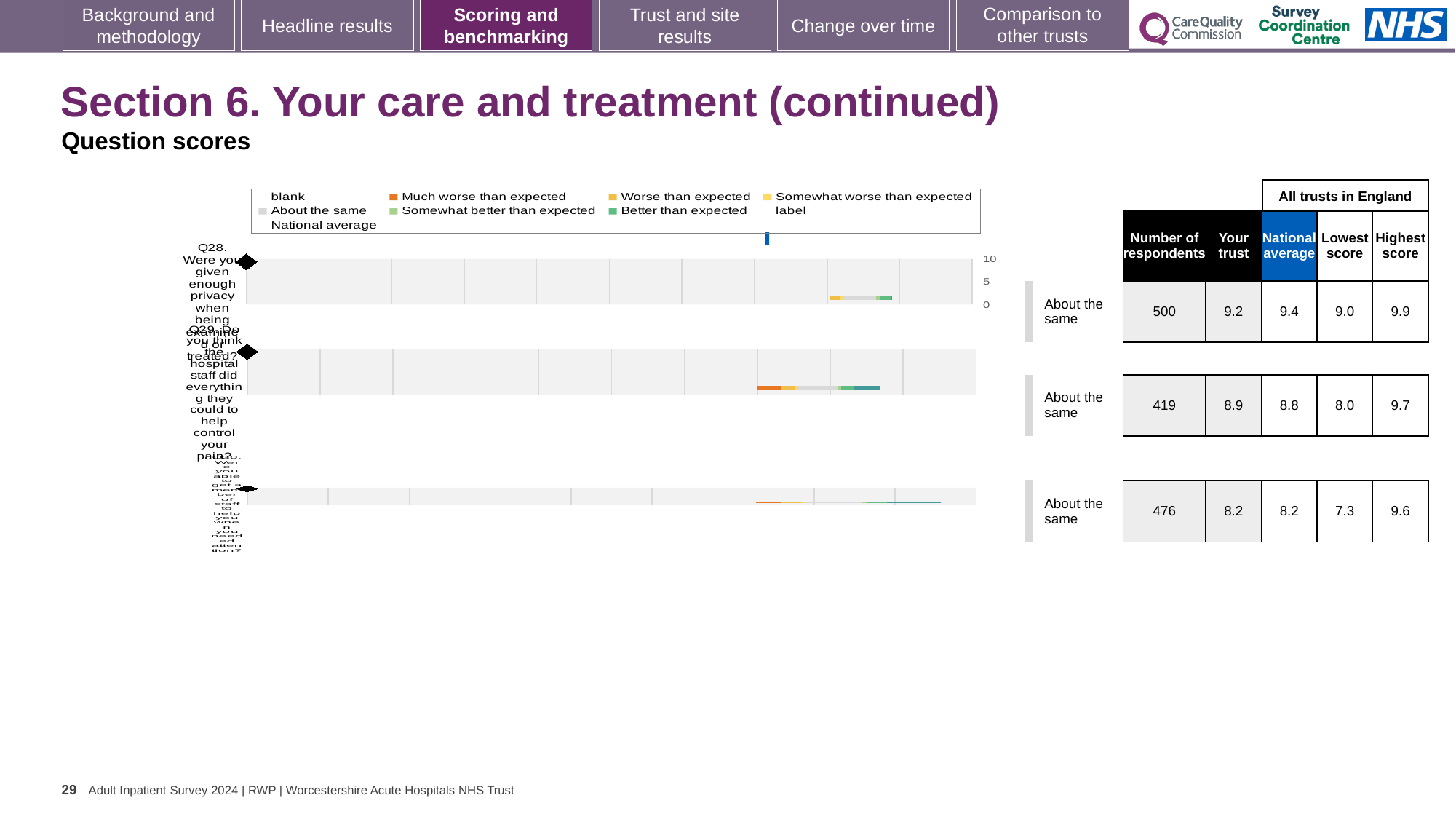
What is the national average score for Q29 (Do you think the hospital staff did everything they could to help control your pain?)? 8.8 What benchmark label is shown for Q28? About the same What kind of chart is shown on the slide? bar chart For Q29, which is larger: the 'Your trust' score or the national average? Your trust Which question has the lowest 'Your trust' score? Q30 What is the 'Your trust' score for Q28 (Were you given enough privacy when being examined or treated?)? 9.2 What is the difference between the highest score (9.9) and the lowest score (9.0) for Q28? 0.9 Which question has the highest 'Your trust' score? Q28 What is the lowest score across all trusts in England for Q30? 7.3 How many respondents answered Q30 (Were you able to get a member of staff to help you when you needed attention?)? 476 What is the highest score across all trusts in England for Q28? 9.9 How many questions (categories) are plotted on the chart? 3